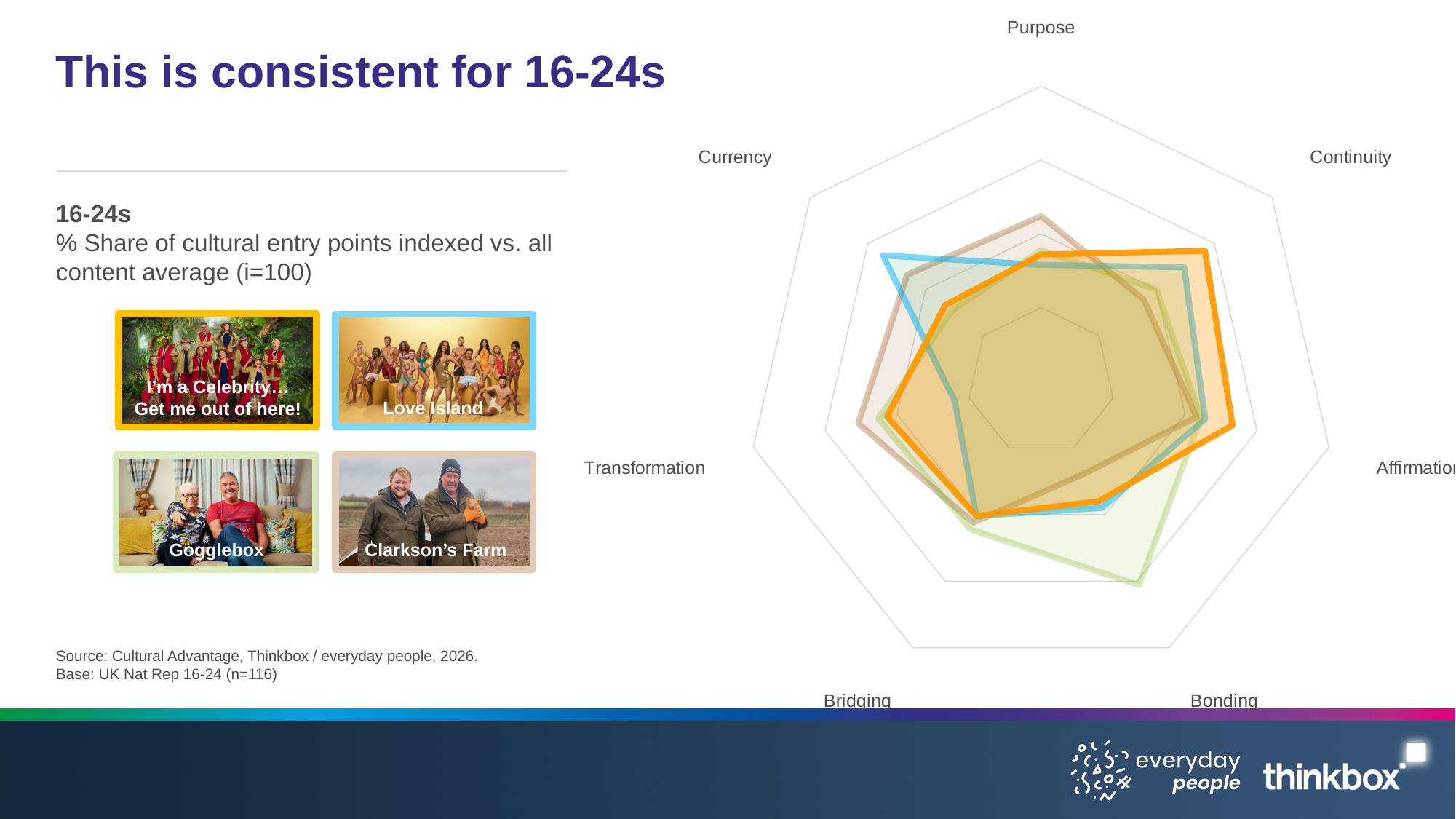
What is the sample size (n) given in the base note for the chart? 116 Which programme has the highest value on the Purpose axis? Clarkson's Farm Which programme has the highest value on the Currency axis? Love Island What is the title of the slide? This is consistent for 16-24s How many programmes (series) are plotted on the radar chart? 4 On the Purpose axis, which is larger: Clarkson's Farm or Gogglebox? Clarkson's Farm Which programme has the highest value on the Bonding axis? Gogglebox How many axes (cultural entry points) does the radar chart have? 7 What kind of chart is shown on the slide? Radar chart On the Bonding axis, which is larger: Gogglebox or Love Island? Gogglebox